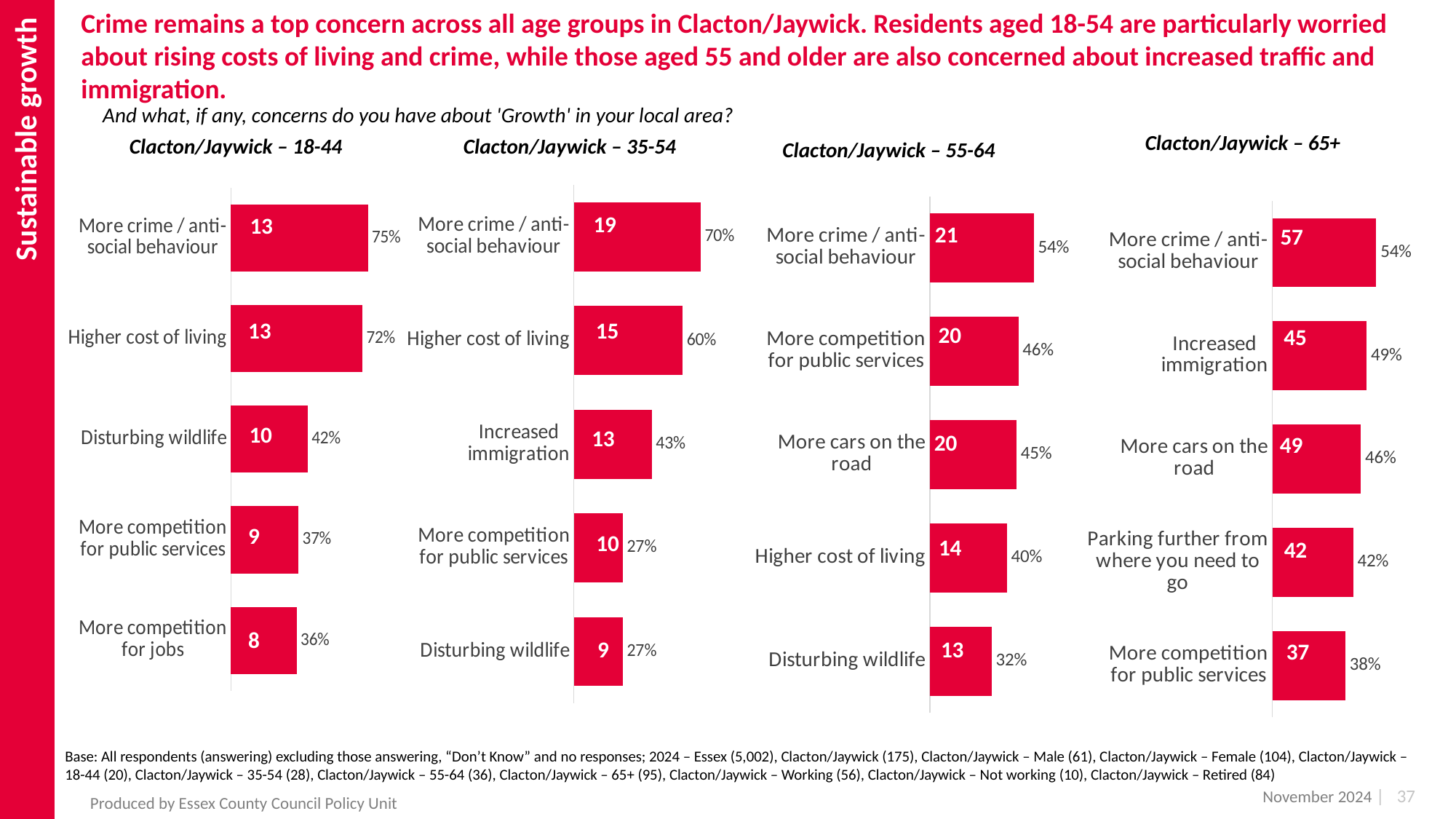
How many charts are shown on the slide? 4 In the 'Clacton/Jaywick – 35-54' chart, what is the count shown inside the bar for 'More crime / anti-social behaviour'? 19 In the 'Clacton/Jaywick – 18-44' chart, what percentage is shown for 'Higher cost of living'? 72% In the 'Clacton/Jaywick – 35-54' chart, what is the difference in percentage points between 'More crime / anti-social behaviour' and 'Higher cost of living'? 10 In the 'Clacton/Jaywick – 55-64' chart, what percentage is shown for 'More cars on the road'? 45% In the 'Clacton/Jaywick – 65+' chart, what is the count shown inside the bar for 'Increased immigration'? 45 In the 'Clacton/Jaywick – 65+' chart, which concern has the highest percentage? More crime / anti-social behaviour In the 'Clacton/Jaywick – 55-64' chart, which concern has the lowest percentage? Disturbing wildlife How many concerns are plotted in the 'Clacton/Jaywick – 65+' chart? 5 What type of chart is used for the 'Clacton/Jaywick – 18-44' data? Bar chart In the 'Clacton/Jaywick – 65+' chart, what percentage is shown for 'Parking further from where you need to go'? 42% In the 'Clacton/Jaywick – 18-44' chart, which has a higher percentage: 'Disturbing wildlife' or 'More competition for public services'? Disturbing wildlife